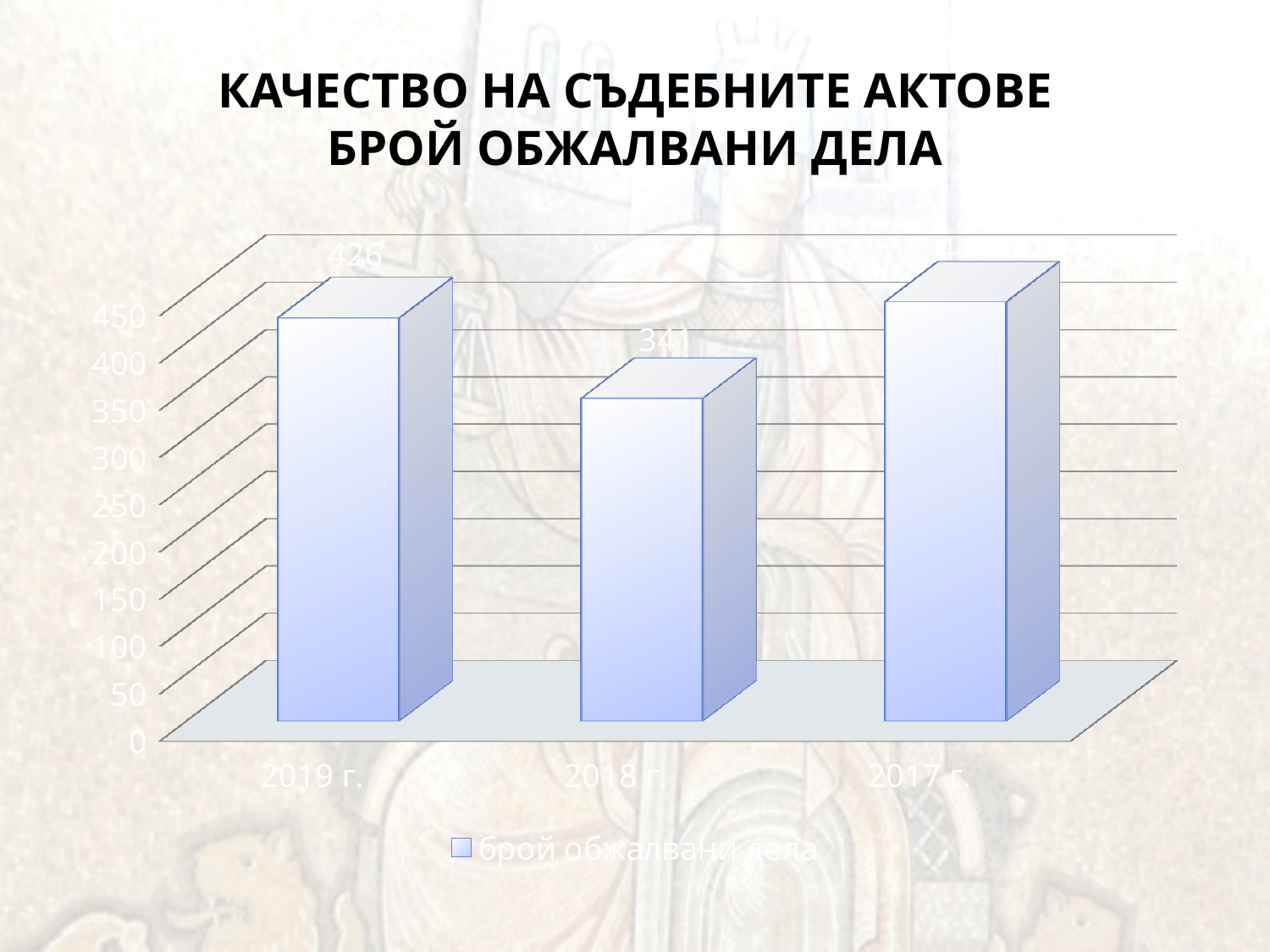
What is the value for 2019 г.? 426 What is the legend entry of the chart? брой обжалвани дела How many years are shown on the x axis? 3 How many series does the legend list? 1 Is the value for 2017 г. greater or less than 400? greater Which year has the lowest number of appealed cases? 2018 г. What kind of chart is shown on the slide? bar chart Is the value for 2018 г. greater or less than 400? less Which year has the highest bar? 2017 г. Which is larger, the value for 2019 г. or the value for 2018 г.? 2019 г. What is the difference between the values for 2019 г. and 2018 г.? 85 What is the value for 2018 г.? 341